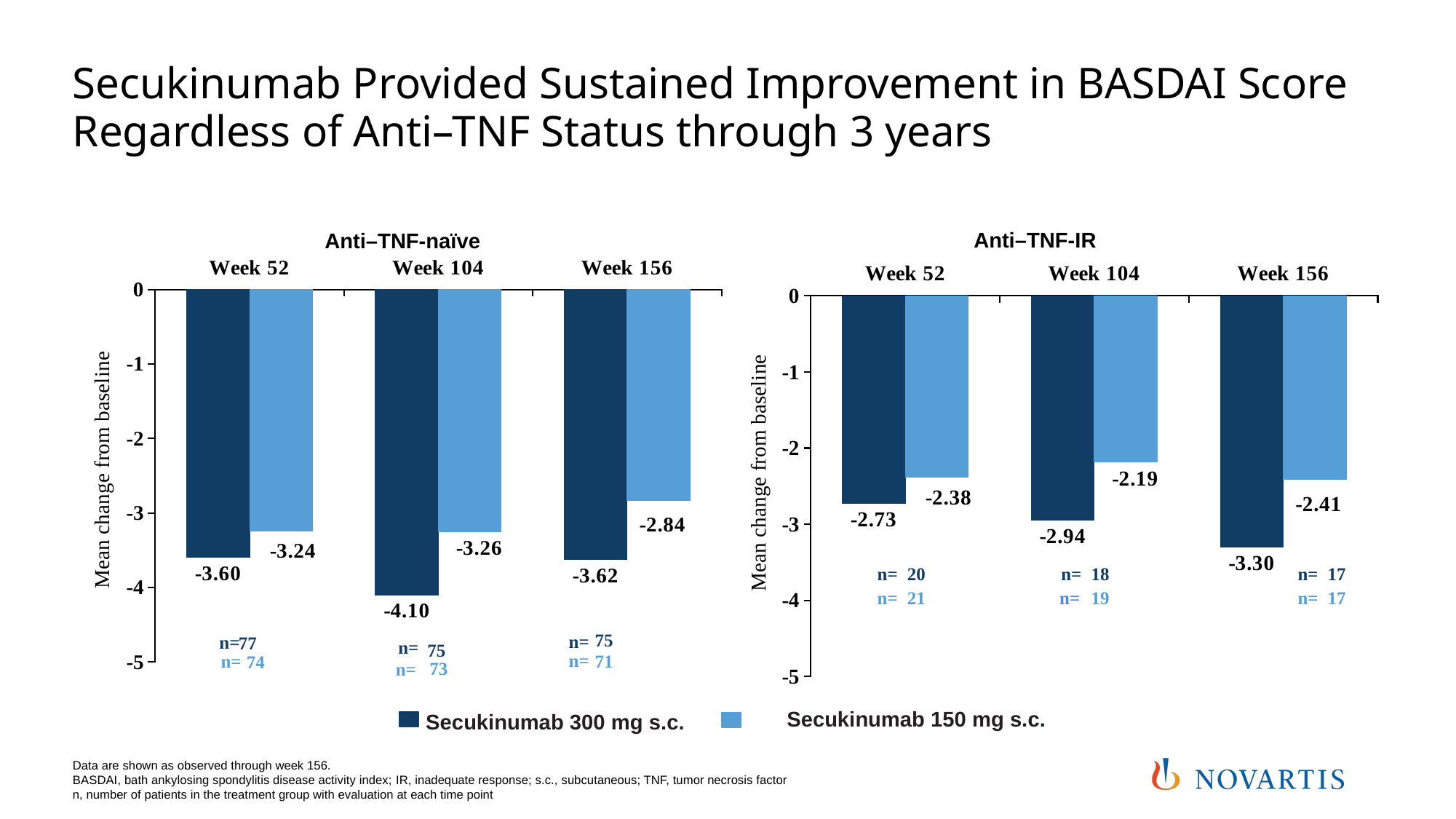
How many time points (weeks) are shown in the Anti–TNF-IR chart? 3 In the Anti–TNF-IR chart, what is the mean change from baseline for Secukinumab 300 mg s.c. at Week 52? -2.73 How many series does the legend list? 2 In the Anti–TNF-IR chart, what is the mean change from baseline for Secukinumab 150 mg s.c. at Week 156? -2.41 In the Anti–TNF-naïve chart, what is the mean change from baseline for Secukinumab 150 mg s.c. at Week 52? -3.24 In the Anti–TNF-naïve chart, what is the mean change from baseline for Secukinumab 300 mg s.c. at Week 104? -4.10 In the Anti–TNF-IR chart, at which week does Secukinumab 150 mg s.c. show the smallest (least negative) mean change from baseline? Week 104 In the Anti–TNF-naïve chart, is the Secukinumab 300 mg s.c. value at Week 104 greater or less than -4? less In the Anti–TNF-IR chart, which dose shows the more negative mean change from baseline at Week 104? Secukinumab 300 mg s.c. In the Anti–TNF-naïve chart, what is the difference between the Secukinumab 300 mg s.c. and 150 mg s.c. values at Week 156? 0.78 In the Anti–TNF-naïve chart, at which week does Secukinumab 300 mg s.c. show the lowest (most negative) mean change from baseline? Week 104 In the Anti–TNF-IR chart, do the Secukinumab 300 mg s.c. values rise or fall from Week 52 to Week 156? fall